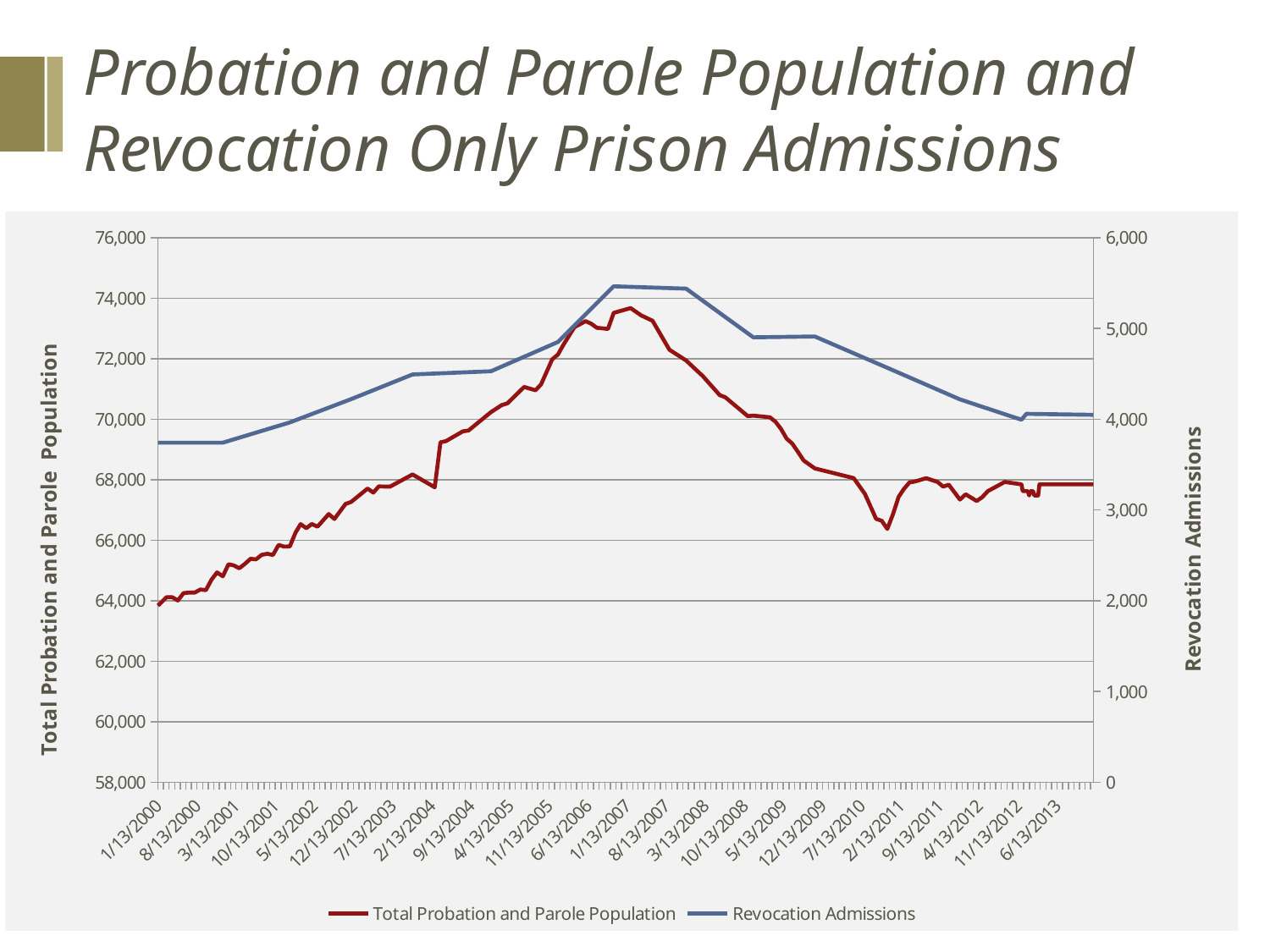
Does the Revocation Admissions line rise or fall between 1/13/2000 and 1/13/2007? rise How many series does the legend list? 2 Is the peak value of Revocation Admissions greater or less than 5,000? greater Does the Revocation Admissions line rise or fall between 8/13/2007 and 6/13/2013? fall What are the two series named in the legend? Total Probation and Parole Population; Revocation Admissions Is the value for Total Probation and Parole Population at 2/13/2011 greater or less than 68,000? less Is the value for Total Probation and Parole Population at 1/13/2000 greater or less than 66,000? less What kind of chart is shown on the slide? Line chart What is the label of the right-hand vertical axis? Revocation Admissions